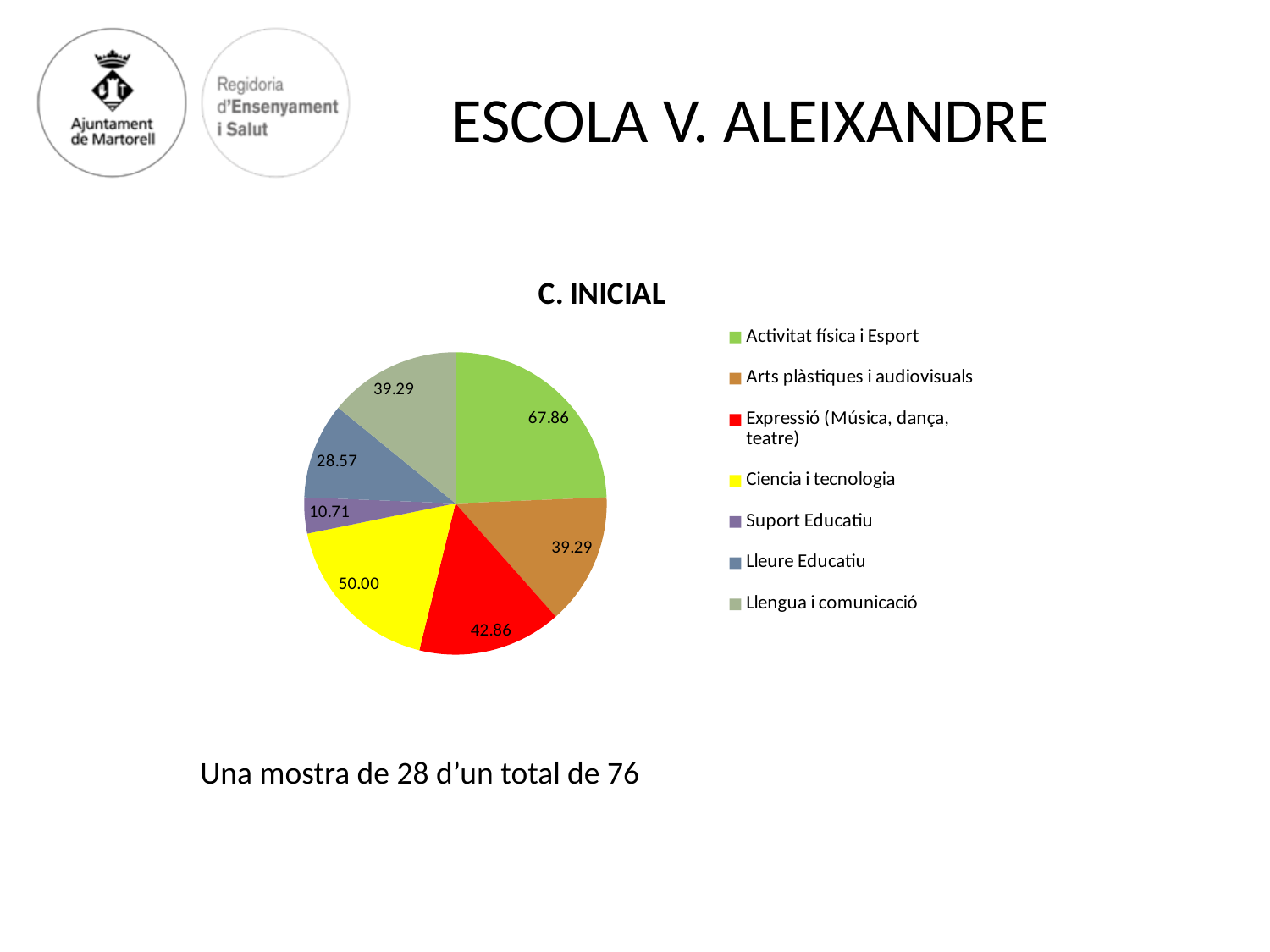
Which category has the largest slice in the C. INICIAL pie chart? Activitat física i Esport What is the value for Ciencia i tecnologia in the C. INICIAL pie chart? 50.00 What is the difference between the values for Expressió (Música, dança, teatre) and Lleure Educatiu in the C. INICIAL pie chart? 14.29 Which category has the smallest slice in the C. INICIAL pie chart? Suport Educatiu What is the value for Activitat física i Esport in the C. INICIAL pie chart? 67.86 What is the value for Lleure Educatiu in the C. INICIAL pie chart? 28.57 What is the difference between the values for Activitat física i Esport and Ciencia i tecnologia in the C. INICIAL pie chart? 17.86 What colour is the Ciencia i tecnologia slice in the C. INICIAL pie chart? Yellow What type of chart is shown on the slide? Pie chart In the C. INICIAL pie chart, which is larger: Expressió (Música, dança, teatre) or Arts plàstiques i audiovisuals? Expressió (Música, dança, teatre) How many categories does the C. INICIAL pie chart show? 7 What is the value for Suport Educatiu in the C. INICIAL pie chart? 10.71